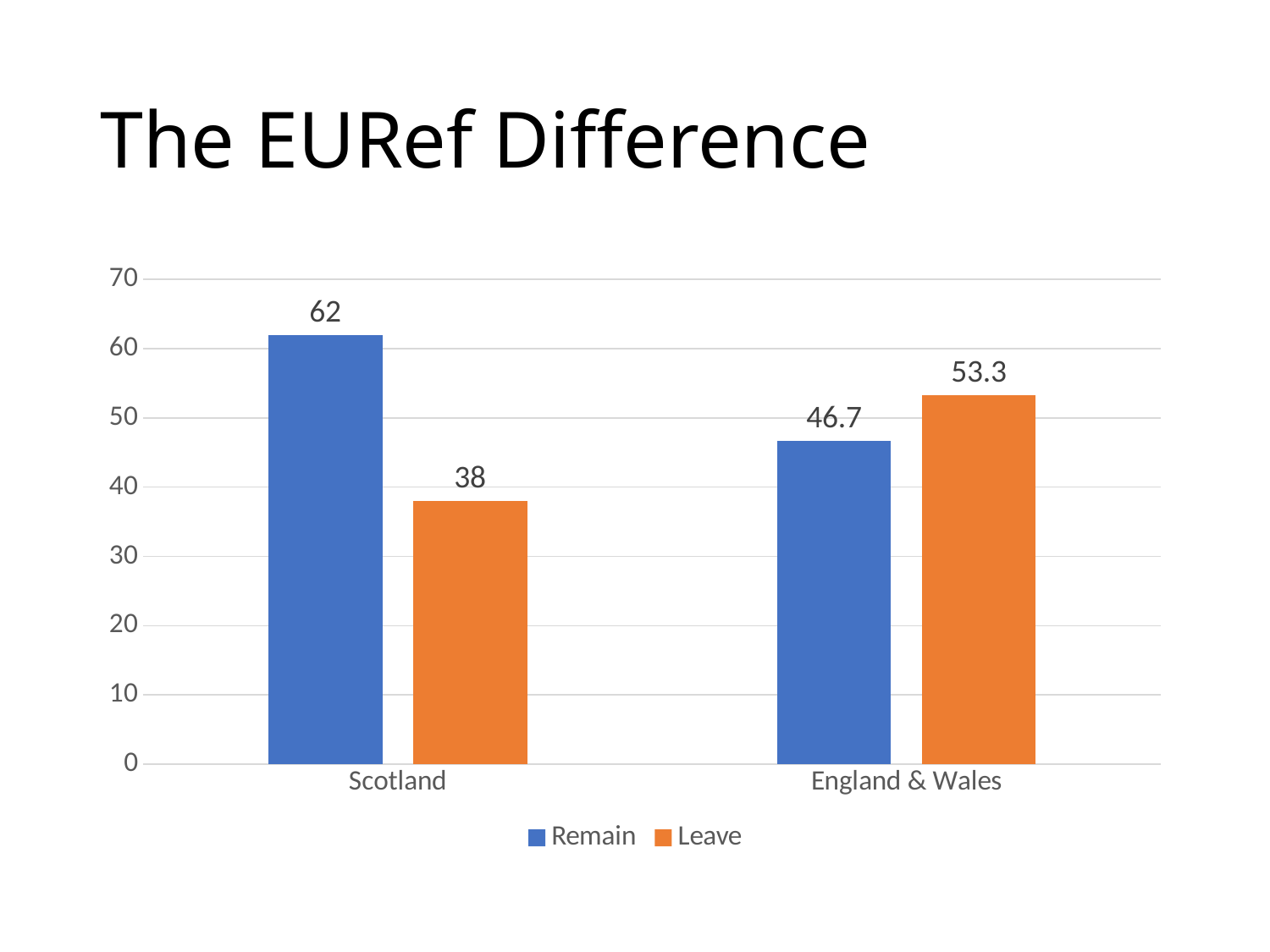
Which is larger for England & Wales, Remain or Leave? Leave What is the Remain value for England & Wales? 46.7 What is the difference between the Remain and Leave values for Scotland? 24 What is the difference between the Leave and Remain values for England & Wales? 6.6 Which category has the highest Remain value? Scotland How many series does the legend list? 2 What kind of chart is shown on the slide? bar chart What is the Remain value for Scotland? 62 Is the Leave value for Scotland greater or less than 40? less How many categories are shown on the x axis? 2 What is the Leave value for England & Wales? 53.3 Which category has the lowest Leave value? Scotland